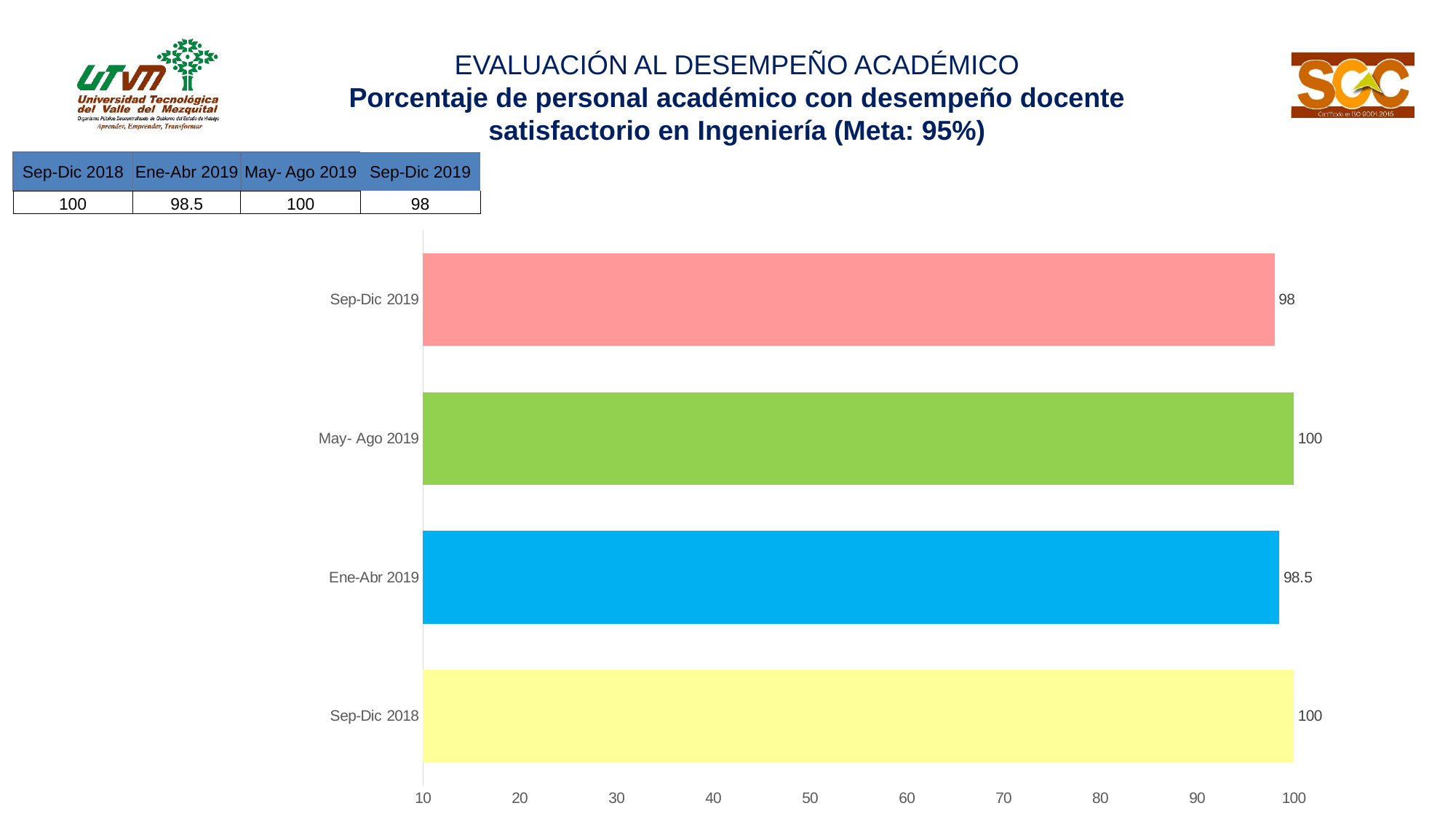
What is the difference between the values for Sep-Dic 2018 and Sep-Dic 2019? 2 What is the value for Sep-Dic 2018? 100 What target (Meta) is stated in the chart title? 95% What is the value for Ene-Abr 2019? 98.5 Which is larger, the value for Ene-Abr 2019 or the value for Sep-Dic 2019? Ene-Abr 2019 Is the value for Sep-Dic 2019 greater or less than 90? greater How many periods are shown in the chart? 4 What is the value for Sep-Dic 2019? 98 What is the value for May- Ago 2019? 100 Which period has the lowest value? Sep-Dic 2019 What kind of chart is shown on the slide? bar chart What is the difference between the values for May- Ago 2019 and Ene-Abr 2019? 1.5